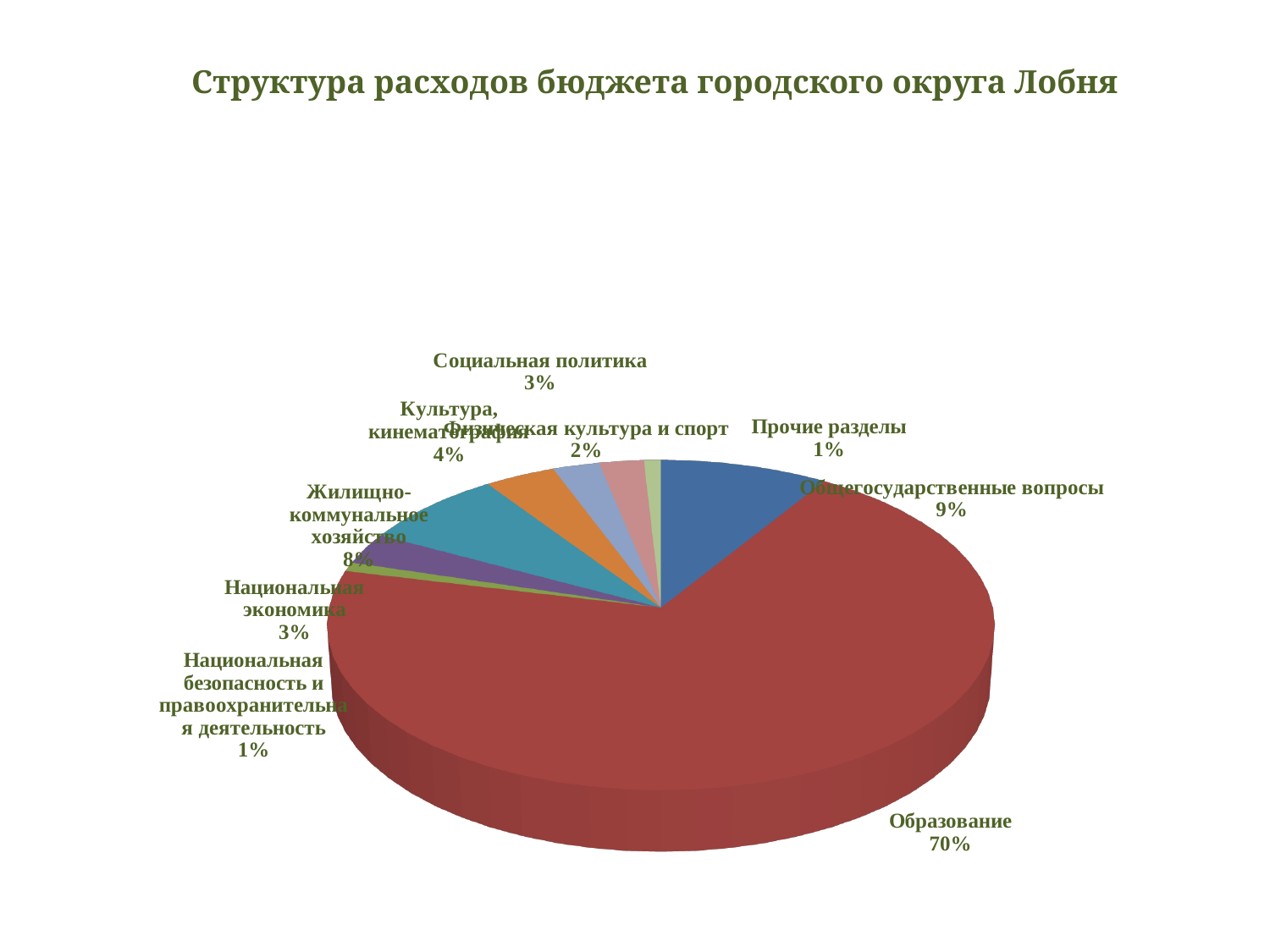
What share of the budget expenditure goes to Жилищно-коммунальное хозяйство? 8% What share of the budget expenditure goes to Общегосударственные вопросы? 9% How many categories are shown in the pie chart? 9 What share of the budget expenditure goes to Образование? 70% What share of the budget expenditure goes to Прочие разделы? 1% Which is larger: the share for Общегосударственные вопросы or the share for Жилищно-коммунальное хозяйство? Общегосударственные вопросы What is the title of the chart? Структура расходов бюджета городского округа Лобня What share of the budget expenditure goes to Физическая культура и спорт? 2% What is the difference in percentage points between the share for Образование and the share for Общегосударственные вопросы? 61 What share of the budget expenditure goes to Социальная политика? 3% Which category has the largest share of the budget expenditure? Образование What kind of chart is shown on the slide? pie chart